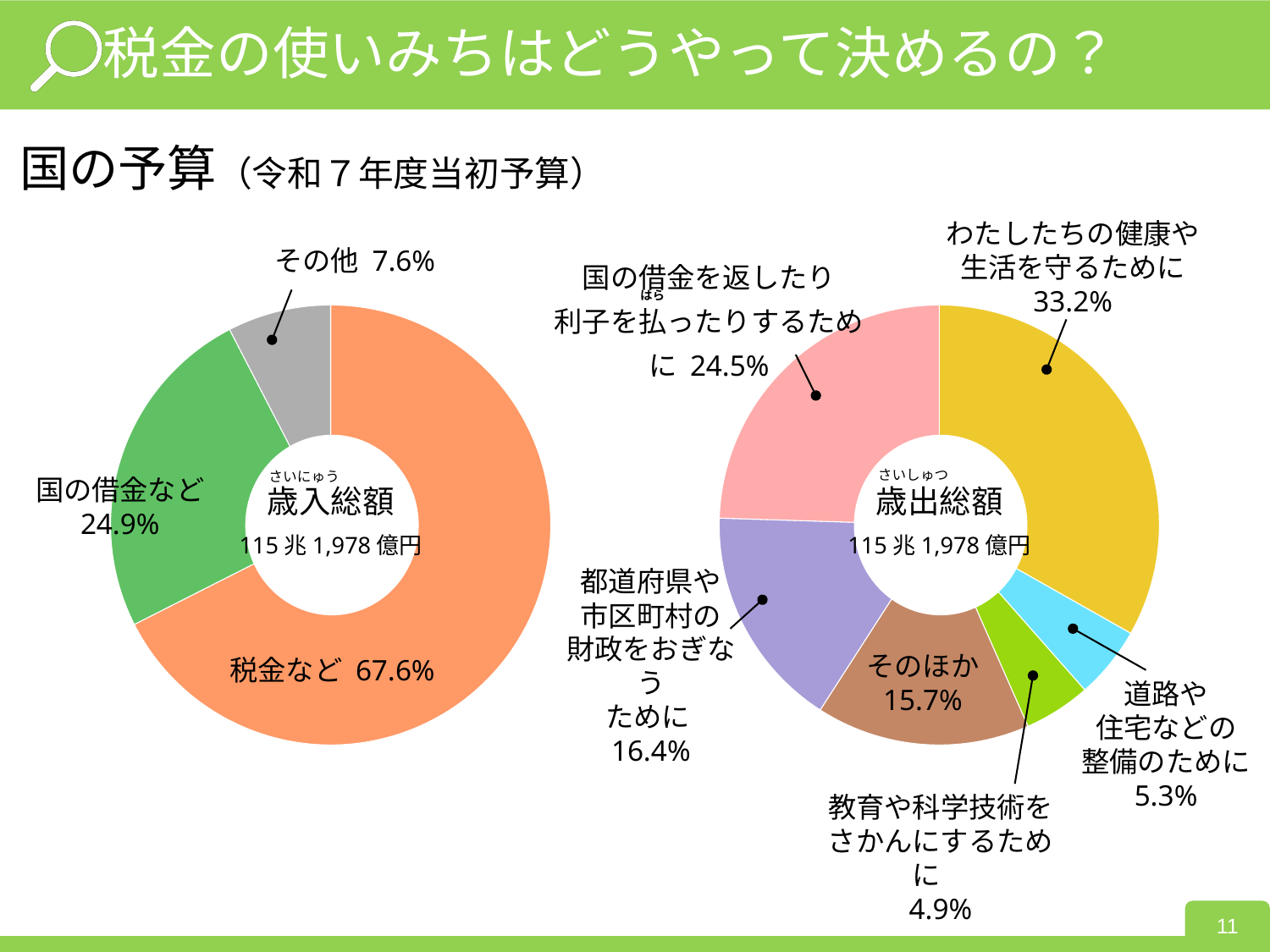
In the 歳出総額 chart on the right, how many categories are shown? 6 In the 歳入総額 chart on the left, what share is labelled for 税金など? 67.6% In the 歳出総額 chart on the right, what share is labelled for 道路や住宅などの整備のために? 5.3% What total amount is printed in the centre of the 歳出総額 chart on the right? 115兆1,978億円 In the 歳入総額 chart on the left, what is the difference between the shares of 税金など and 国の借金など? 42.7% In the 歳出総額 chart on the right, which category has the largest share? わたしたちの健康や生活を守るために In the 歳出総額 chart on the right, which category has the smallest share? 教育や科学技術をさかんにするために In the 歳出総額 chart on the right, which is larger: 都道府県や市区町村の財政をおぎなうために or そのほか? 都道府県や市区町村の財政をおぎなうために In the 歳入総額 chart on the left, which category has the smallest share? その他 In the 歳入総額 chart on the left, how many categories are shown? 3 In the 歳入総額 chart on the left, what share is labelled for 国の借金など? 24.9% In the 歳出総額 chart on the right, what share is labelled for わたしたちの健康や生活を守るために? 33.2%